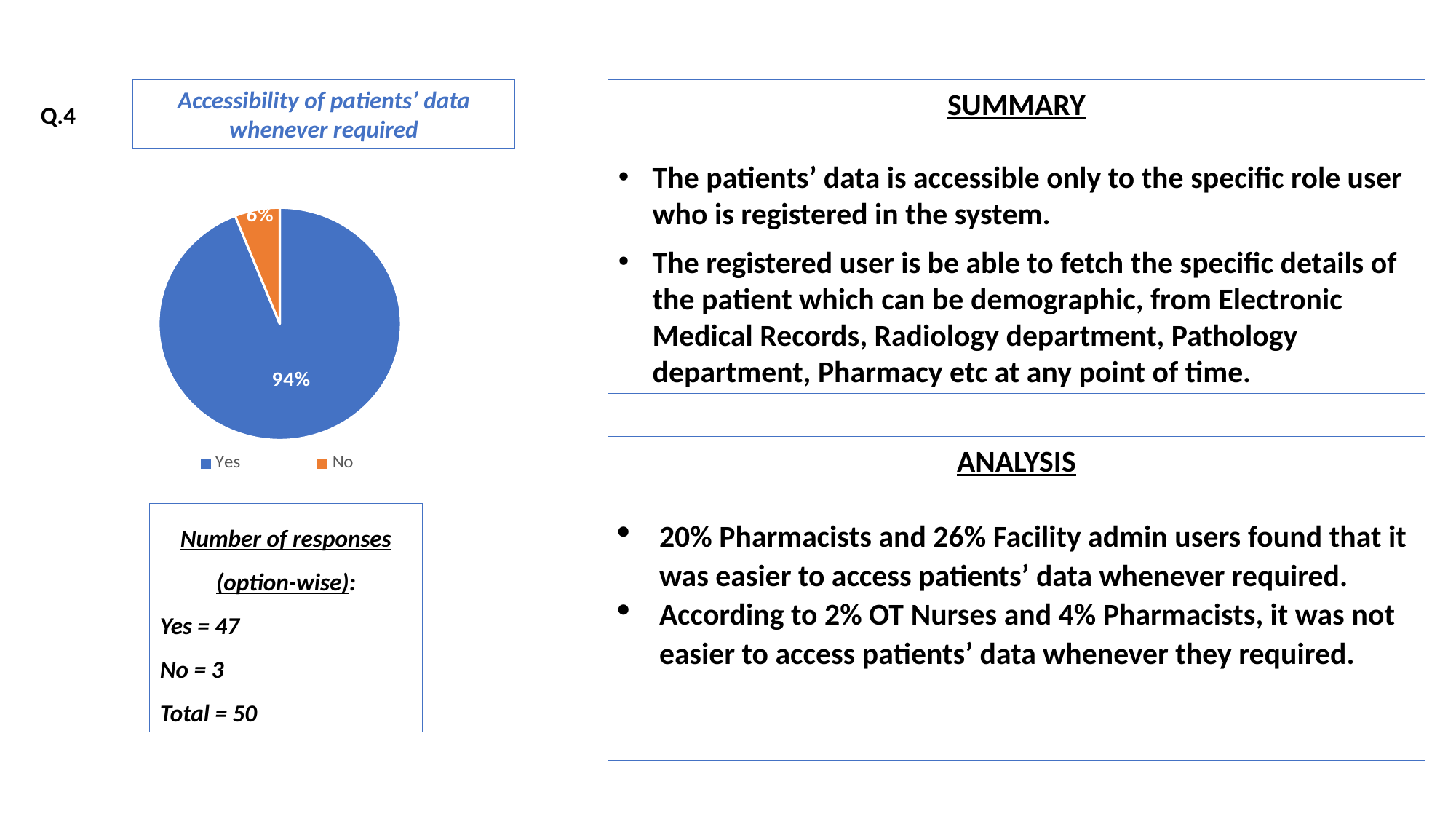
Which slice of the pie is the largest? Yes How many entries does the legend list? 2 What kind of chart is shown on the slide? pie chart Which slice of the pie is the smallest? No How many slices does the pie chart have? 2 What share of the pie does the "No" slice represent? 6% What share of the pie does the "Yes" slice represent? 94% What is the difference in percentage points between the "Yes" and "No" slices? 88 Which is larger, the "Yes" slice or the "No" slice? Yes What is the title of the pie chart? Accessibility of patients' data whenever required What colour is the "No" slice in the pie chart? orange